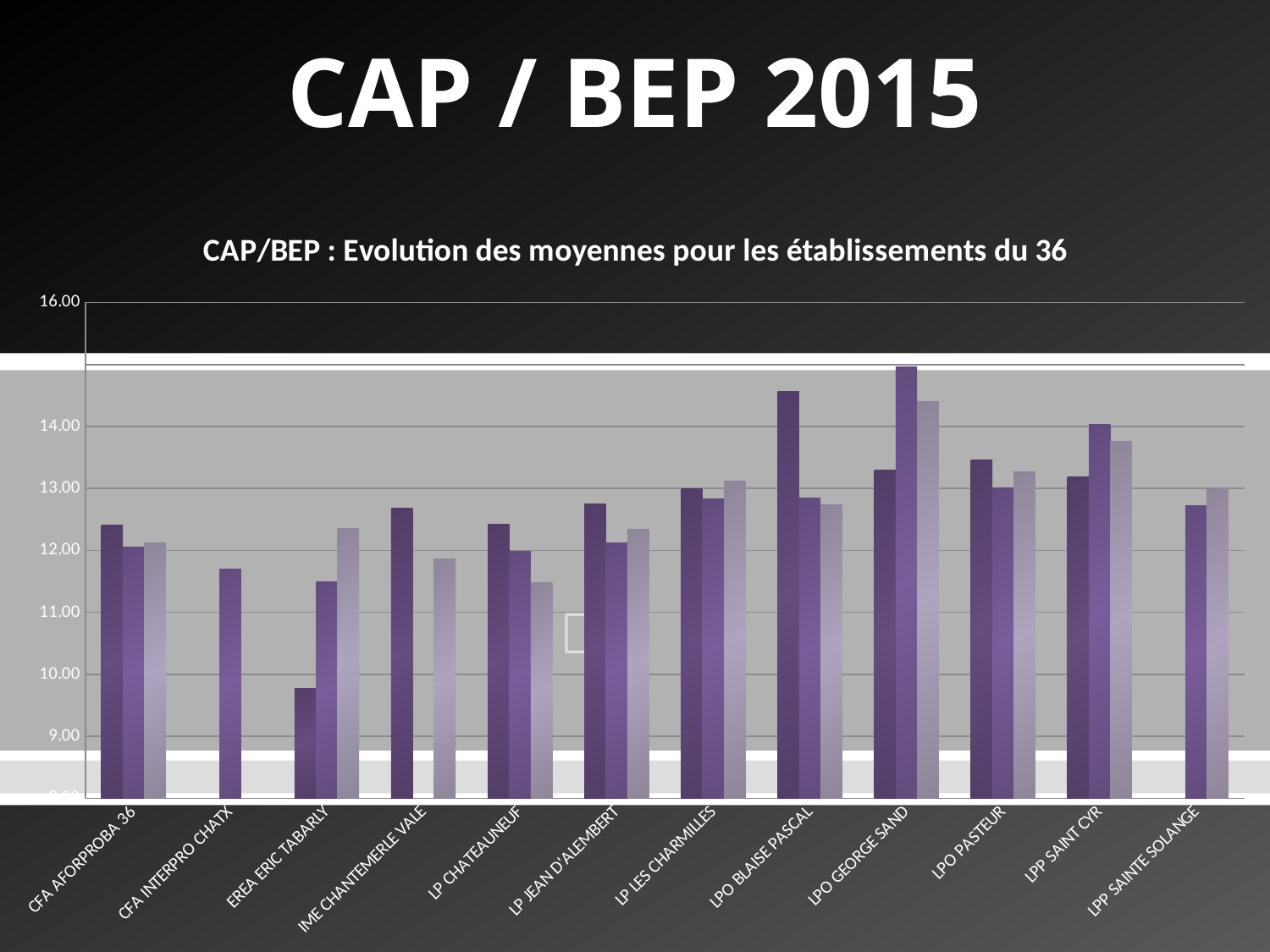
Which has the taller first (darkest) bar: LPO GEORGE SAND or CFA AFORPROBA 36? LPO GEORGE SAND Is the tallest bar for LPO BLAISE PASCAL greater or less than 14.00? greater Is the shortest bar for EREA ERIC TABARLY greater or less than 11.00? less Which establishment has the tallest bar in the chart? LPO GEORGE SAND Is the first (darkest) bar for LPP SAINTE SOLANGE greater or less than 13.00? less How many establishments (categories) are shown on the x axis of the chart? 12 What is the title of the chart? CAP/BEP : Evolution des moyennes pour les établissements du 36 Which establishment has the shortest bar in the chart? EREA ERIC TABARLY What is the highest value shown on the vertical axis of the chart? 16.00 What kind of chart is shown on the slide? bar chart